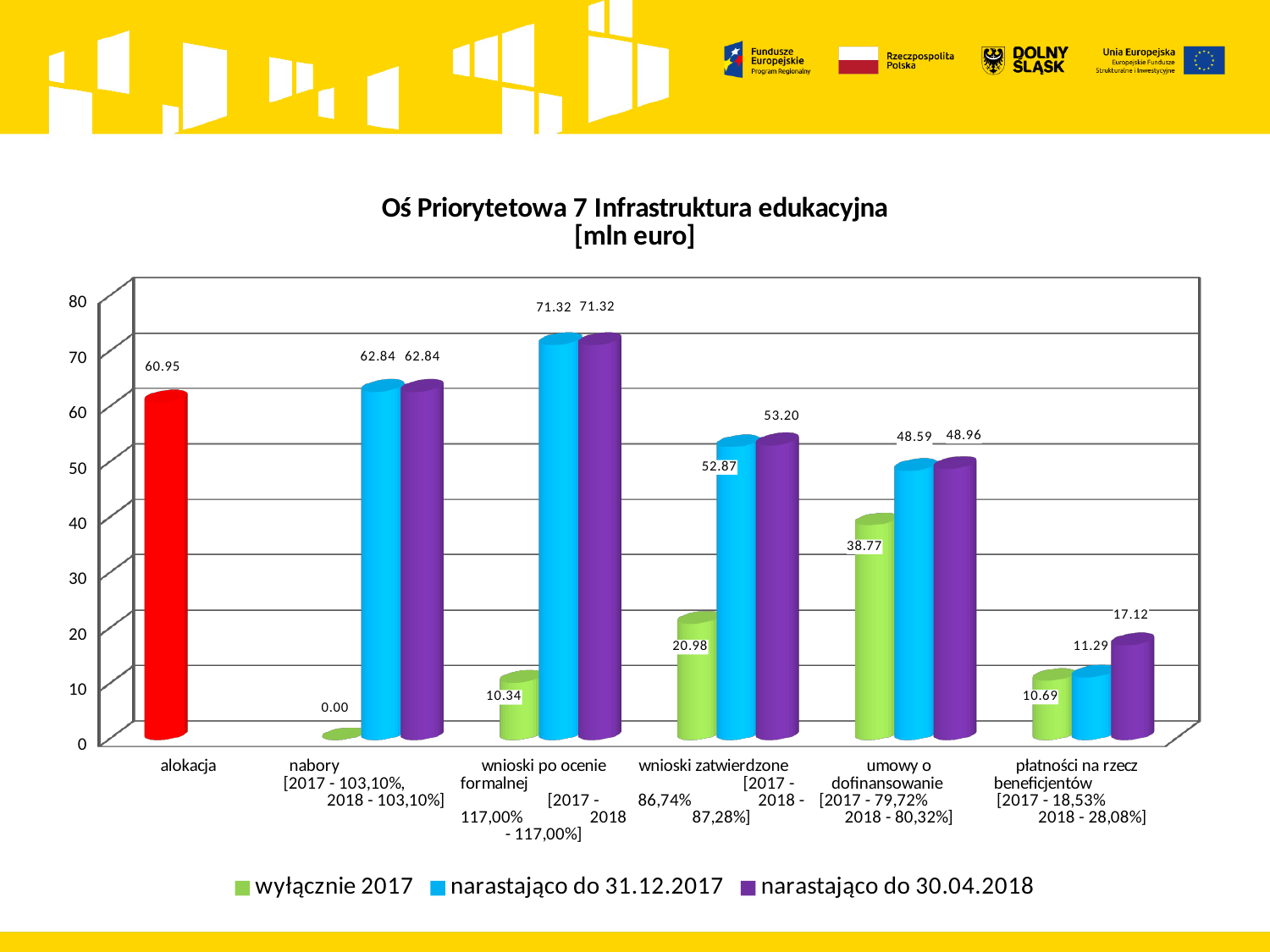
What is the value for 'narastająco do 31.12.2017' in the category 'nabory'? 62.84 Which category has the lowest value for 'wyłącznie 2017'? nabory What kind of chart is shown on the slide? bar chart What is the value of the alokacja bar? 60.95 What is the value for 'wyłącznie 2017' in the category 'umowy o dofinansowanie'? 38.77 How many series does the legend list? 3 In the category 'płatności na rzecz beneficjentów', what is the difference between 'narastająco do 30.04.2018' and 'narastająco do 31.12.2017'? 5.83 For the series 'wyłącznie 2017', which is larger: 'umowy o dofinansowanie' or 'wnioski zatwierdzone'? umowy o dofinansowanie What is the value for 'narastająco do 30.04.2018' in the category 'płatności na rzecz beneficjentów'? 17.12 Which category has the highest value for 'narastająco do 31.12.2017'? wnioski po ocenie formalnej How many categories are shown on the x axis? 6 In the category 'wnioski zatwierdzone', what is the difference between 'narastająco do 30.04.2018' and 'narastająco do 31.12.2017'? 0.33